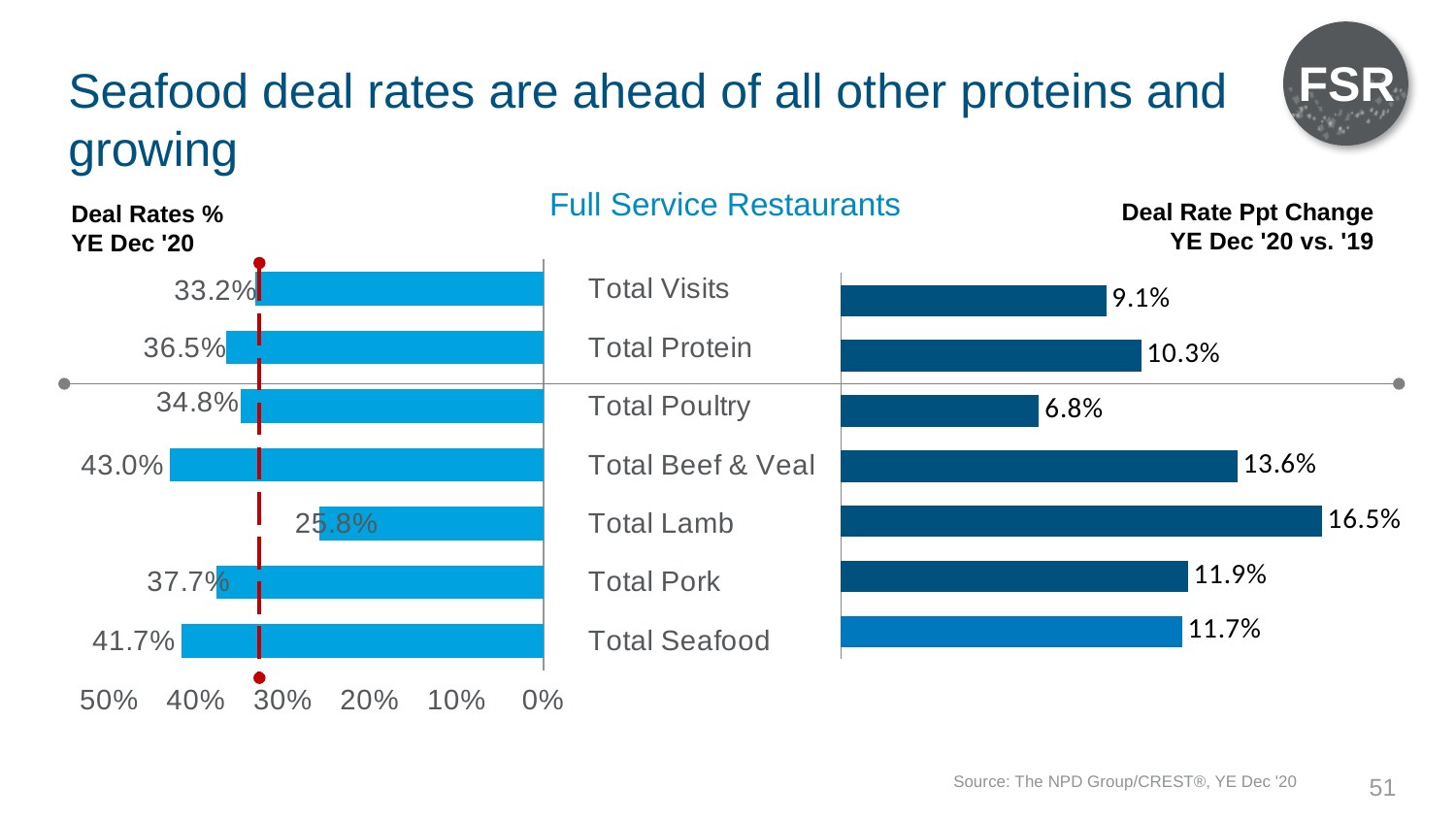
In the Deal Rates % YE Dec '20 chart, which category has the lowest value? Total Lamb In the Deal Rate Ppt Change YE Dec '20 vs. '19 chart, which is larger: Total Pork or Total Seafood? Total Pork In the Deal Rates % YE Dec '20 chart, which category has the highest value? Total Beef & Veal In the Deal Rate Ppt Change YE Dec '20 vs. '19 chart, which category has the lowest value? Total Poultry In the Deal Rate Ppt Change YE Dec '20 vs. '19 chart, what is the difference between Total Protein and Total Visits? 1.2% In the Deal Rate Ppt Change YE Dec '20 vs. '19 chart, which category has the highest value? Total Lamb In the Deal Rates % YE Dec '20 chart, what is the difference between Total Beef & Veal and Total Seafood? 1.3% What kind of chart is the Deal Rate Ppt Change YE Dec '20 vs. '19 chart? Bar chart In the Deal Rates % YE Dec '20 chart, is the value for Total Lamb greater or less than 30%? less How many categories are shown in the Deal Rates % YE Dec '20 chart? 7 In the Deal Rate Ppt Change YE Dec '20 vs. '19 chart, what is the value for Total Lamb? 16.5% In the Deal Rates % YE Dec '20 chart, what is the value for Total Seafood? 41.7%